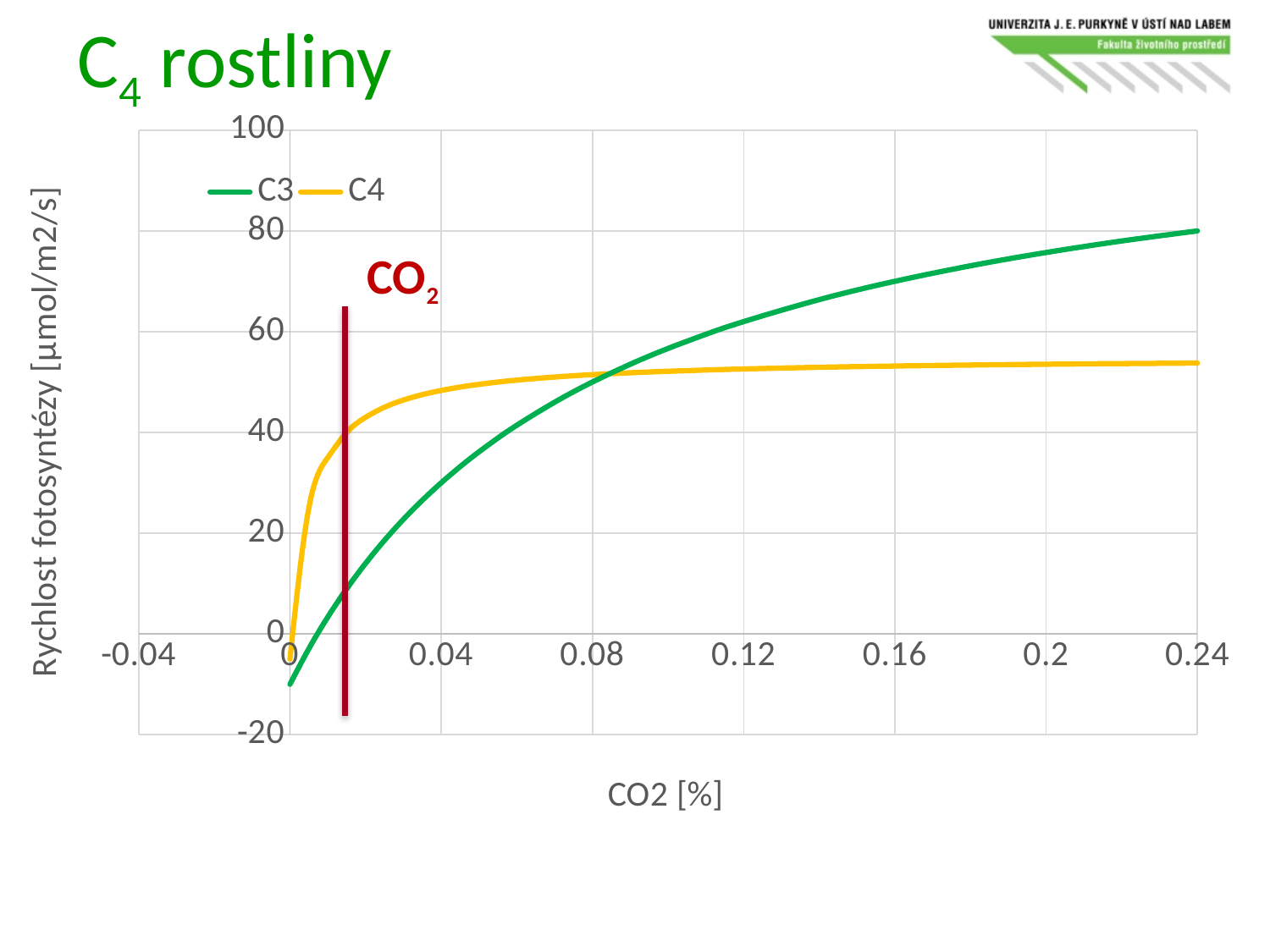
What kind of chart is shown on the slide? line chart At CO2 = 0.24, which series has the higher value, C3 or C4? C3 What is the title of the x axis? CO2 [%] Is the value of the C3 series at CO2 = 0.24 greater or less than 60? greater Is the value of the C4 series at CO2 = 0.24 greater or less than 60? less Is the value of the C3 series at CO2 = 0 greater or less than 0? less How many series does the legend list? 2 What are the two series named in the legend? C3 and C4 At CO2 = 0.04, which series has the higher value, C3 or C4? C4 Does the C3 series rise or fall as CO2 increases along the x axis? rise